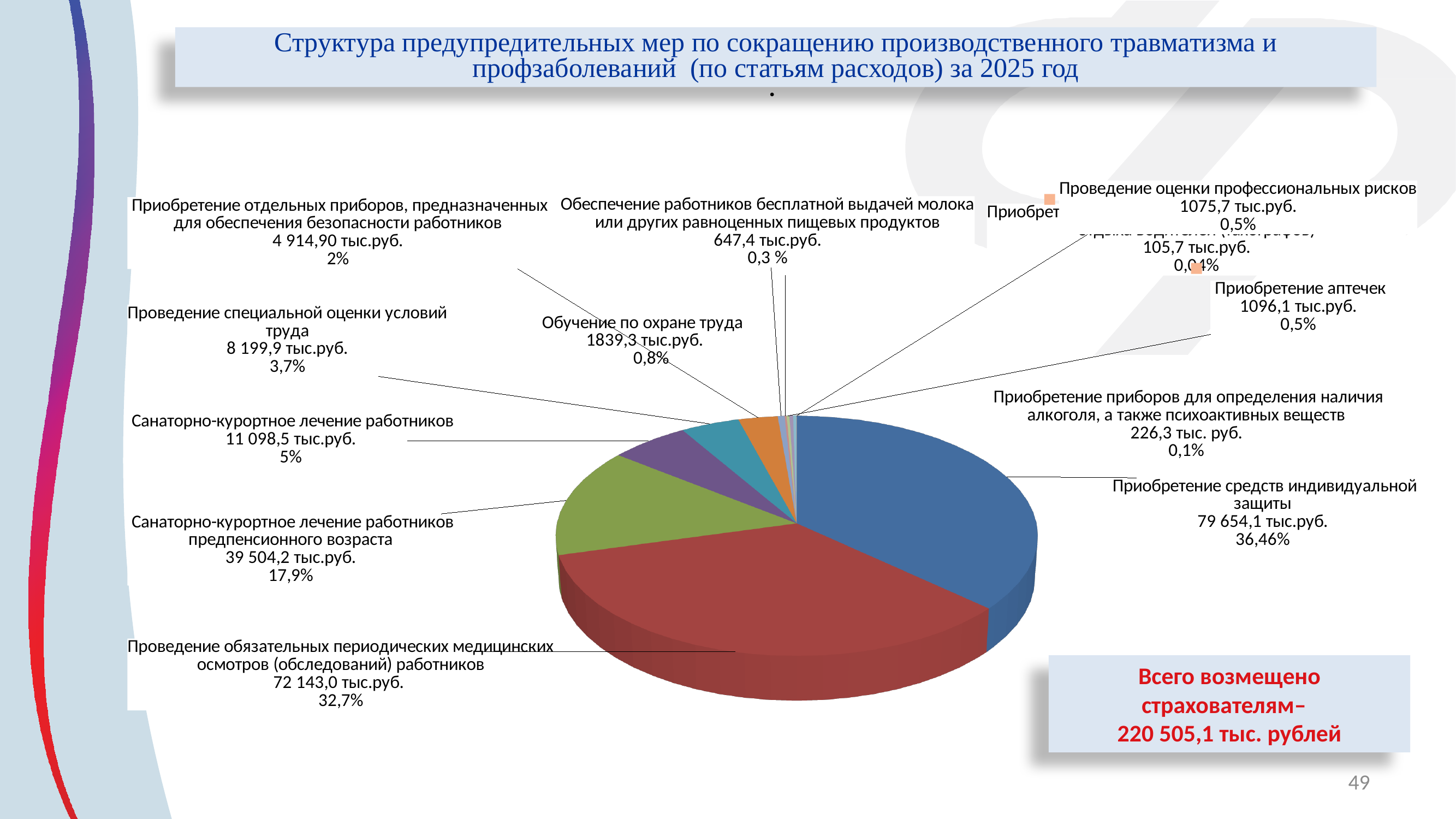
Which expense item has the largest share of the pie? Приобретение средств индивидуальной защиты What percentage is shown for «Приобретение аптечек»? 0,5% For which year does the chart show the structure of preventive measures? 2025 What amount is shown for «Обучение по охране труда»? 1839,3 тыс.руб. What share of the pie does «Проведение обязательных периодических медицинских осмотров (обследований) работников» account for? 32,7% What amount is shown for «Санаторно-курортное лечение работников предпенсионного возраста»? 39 504,2 тыс.руб. What kind of chart is shown on the slide? pie chart What percentage is shown for «Проведение специальной оценки условий труда»? 3,7% What total amount reimbursed to insurers is stated on the slide? 220 505,1 тыс. рублей What amount is shown for «Приобретение средств индивидуальной защиты»? 79 654,1 тыс.руб. What is the difference in amount between «Приобретение средств индивидуальной защиты» and «Проведение обязательных периодических медицинских осмотров (обследований) работников»? 7 511,1 тыс.руб. Which is larger: the amount for «Санаторно-курортное лечение работников» or for «Проведение специальной оценки условий труда»? Санаторно-курортное лечение работников